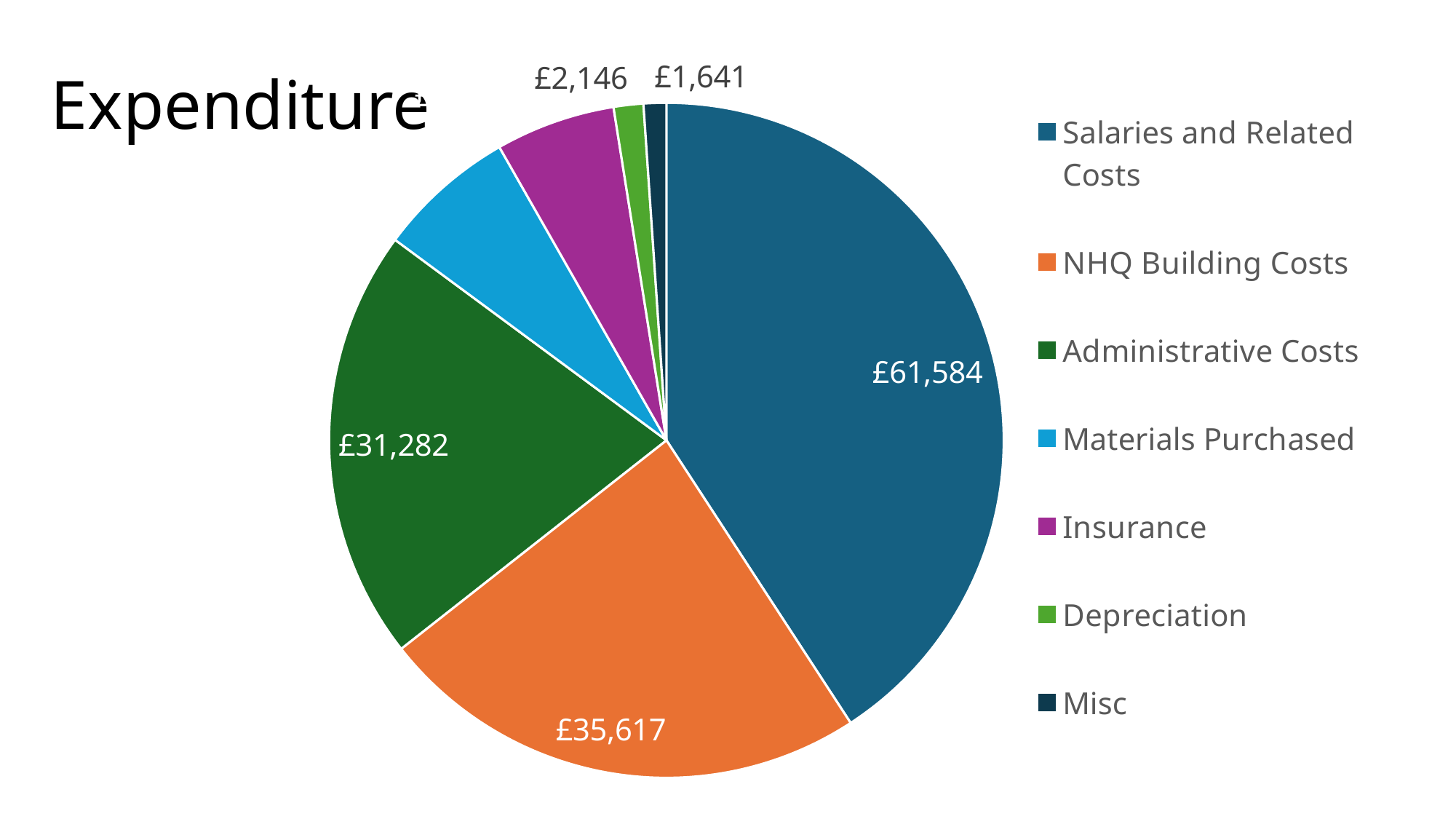
What kind of chart is shown on the slide? pie chart What is the value for Depreciation? £2,146 What is the value for Misc? £1,641 What is the difference between Salaries and Related Costs and NHQ Building Costs? £25,967 Which category has the largest slice of the pie? Salaries and Related Costs What is the title of the slide? Expenditure Which is larger, Administrative Costs or Materials Purchased? Administrative Costs What is the value for Salaries and Related Costs? £61,584 What is the value for Administrative Costs? £31,282 Which category has the smallest slice of the pie? Misc How many categories does the pie chart show? 7 What is the value for NHQ Building Costs? £35,617